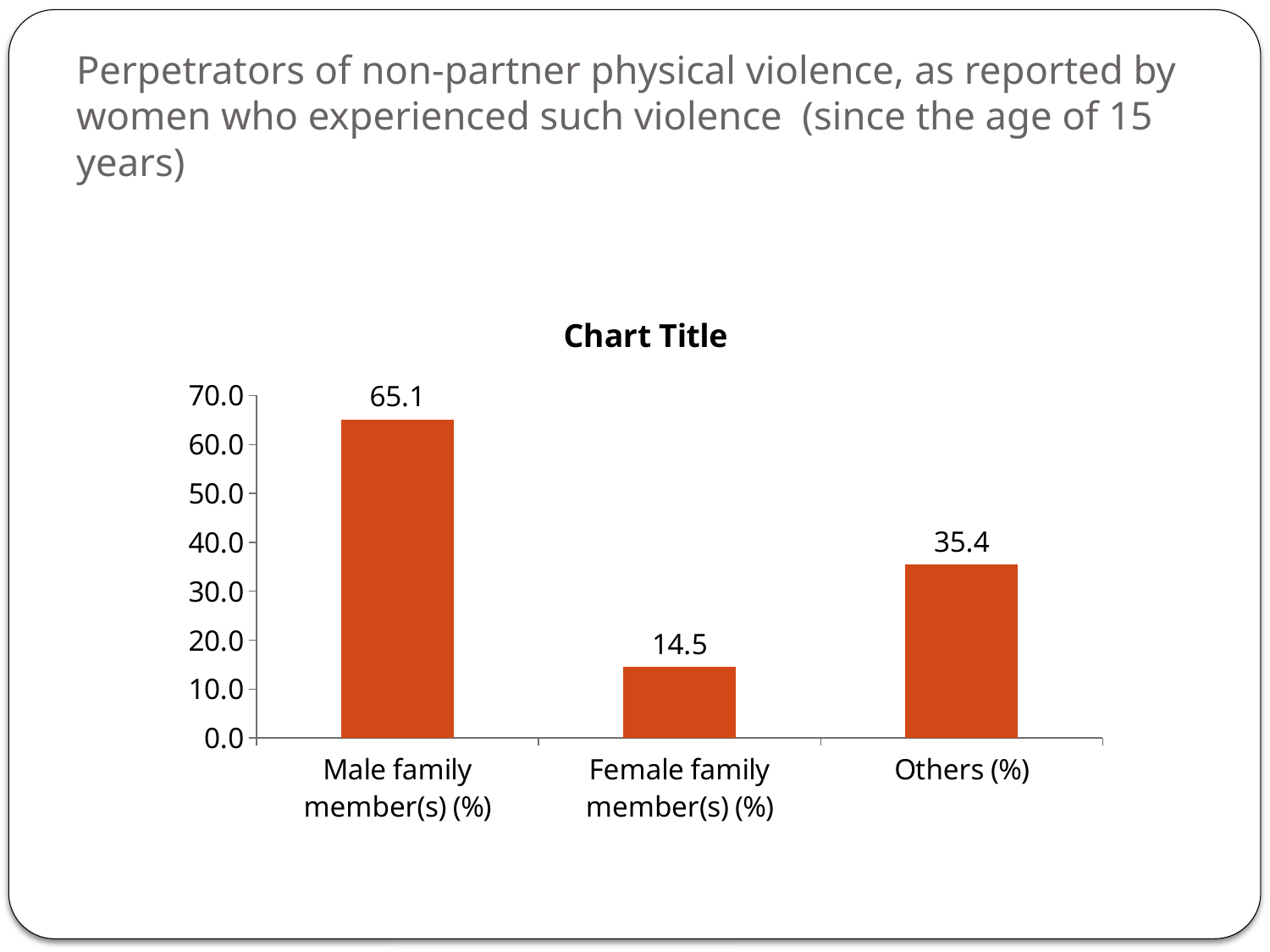
Which category has the lowest value? Female family member(s) (%) What is the difference between the values for Others (%) and Female family member(s) (%)? 20.9 How many categories are shown on the x axis? 3 What is the title printed above the chart? Chart Title What is the value for Male family member(s) (%)? 65.1 What is the difference between the values for Male family member(s) (%) and Others (%)? 29.7 What is the value for Others (%)? 35.4 Which is larger, the value for Others (%) or the value for Female family member(s) (%)? Others (%) Which category has the highest value? Male family member(s) (%) Is the value for Others (%) greater or less than 40.0? less What is the value for Female family member(s) (%)? 14.5 What kind of chart is shown on the slide? bar chart